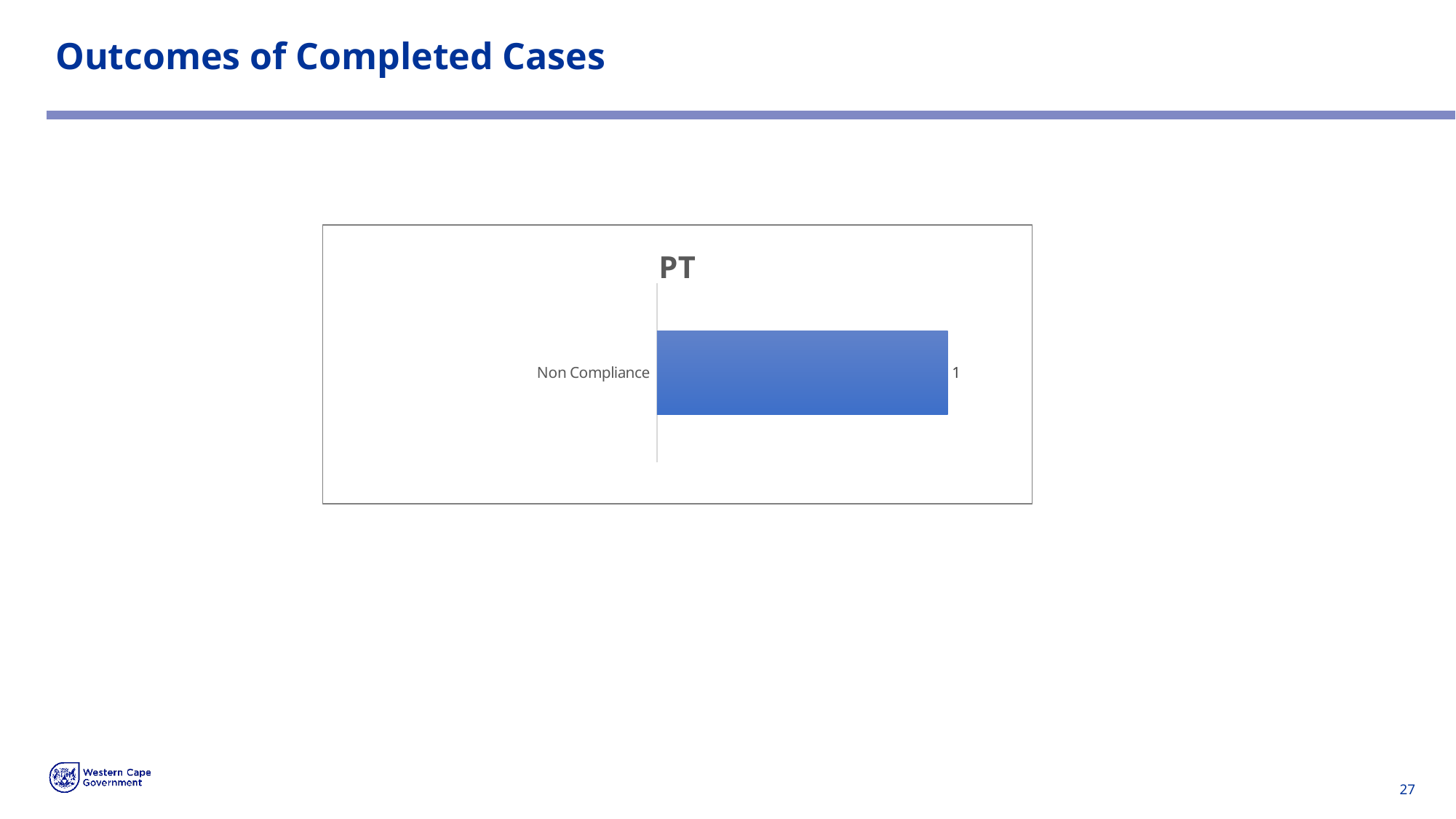
How many categories are shown in the PT chart? 1 Which category has the highest value in the PT chart? Non Compliance What is the value for Non Compliance in the PT chart? 1 Which category is shown in the PT chart? Non Compliance What is the title of the chart on the slide? PT What kind of chart is the PT chart? bar chart